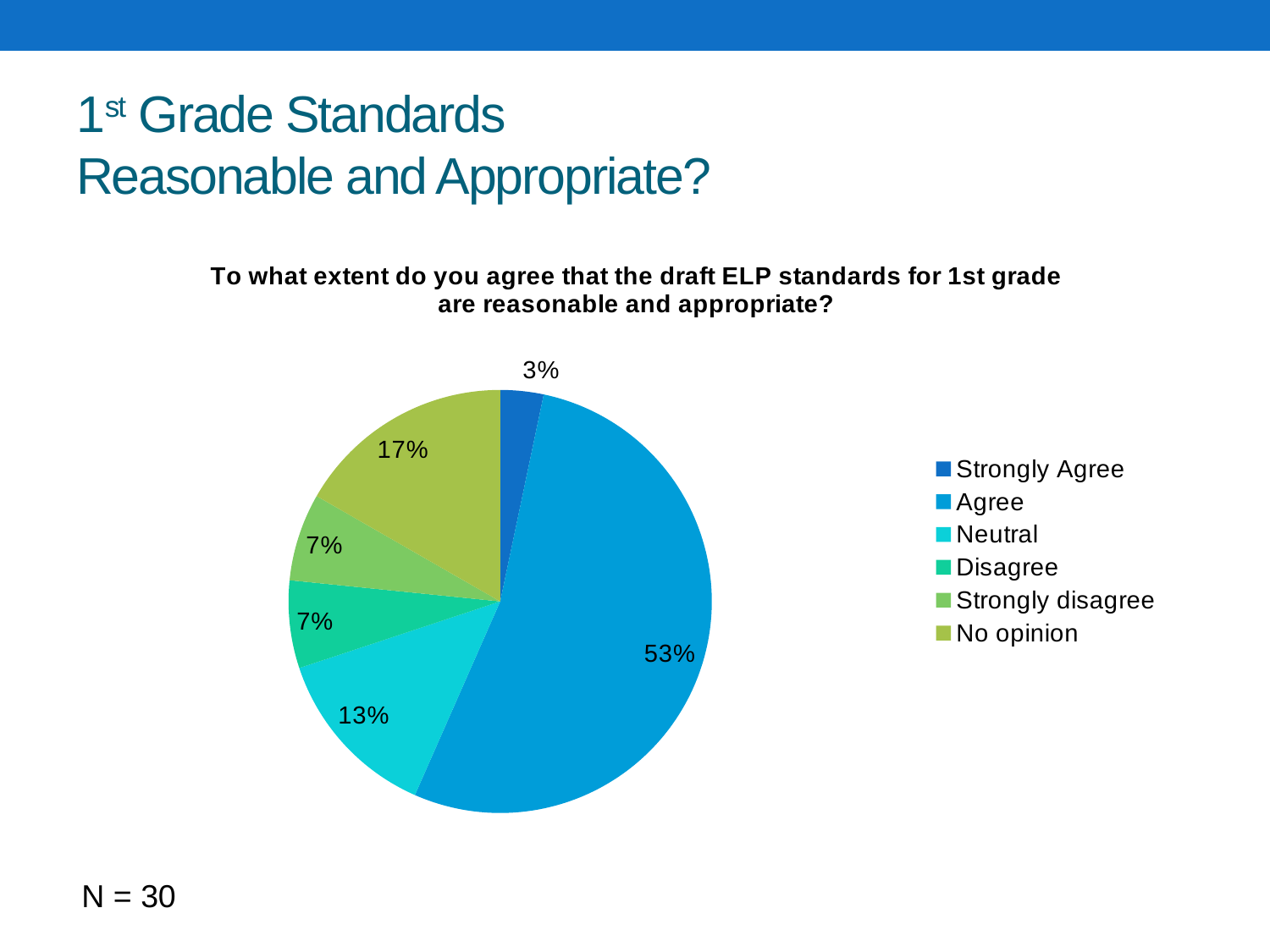
Which response category has the largest share of the pie? Agree What is the title of the chart? To what extent do you agree that the draft ELP standards for 1st grade are reasonable and appropriate? What kind of chart is shown on the slide? pie chart What percentage of respondents chose Neutral? 13% What percentage of respondents chose Agree? 53% What is the combined share of Disagree and Strongly disagree? 14% What is the difference in percentage points between Agree and No opinion? 36 Which response category has the smallest share of the pie? Strongly Agree What percentage of respondents chose No opinion? 17% What percentage of respondents chose Strongly Agree? 3% Which is larger, the share for Neutral or the share for No opinion? No opinion How many response categories does the legend list? 6